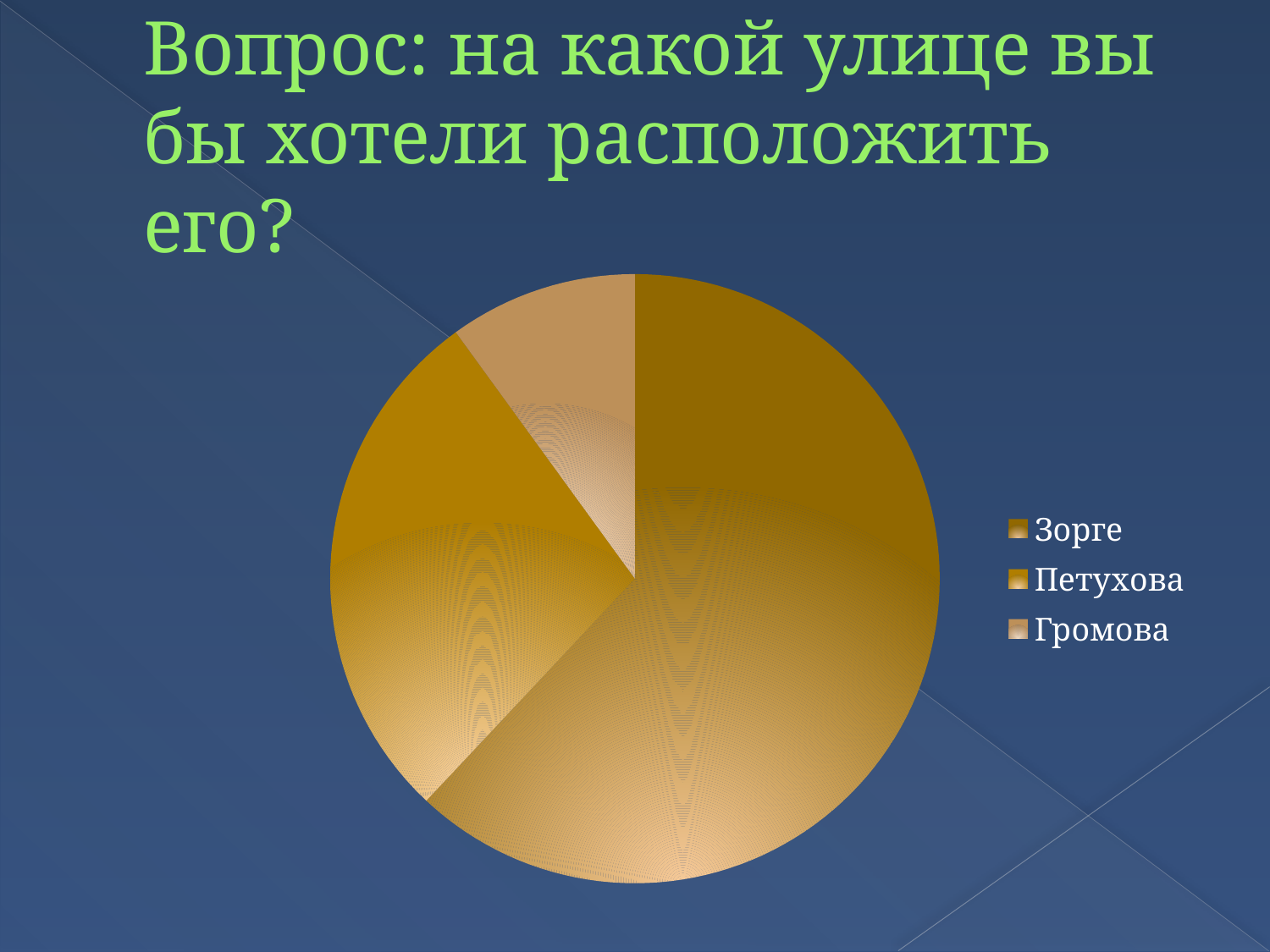
Which street has the smallest slice of the pie? Громова What kind of chart is shown on the slide? pie chart What are the three categories listed in the legend? Зорге, Петухова, Громова What question does the slide title ask? Вопрос: на какой улице вы бы хотели расположить его? Which slice is larger, Петухова or Громова? Петухова Which slice is smaller, Зорге or Громова? Громова How many entries does the legend list? 3 Which street has the largest slice of the pie? Зорге How many slices does the pie chart have? 3 Which slice is larger, Зорге or Петухова? Зорге Does the Зорге slice take up more or less than half of the pie? more